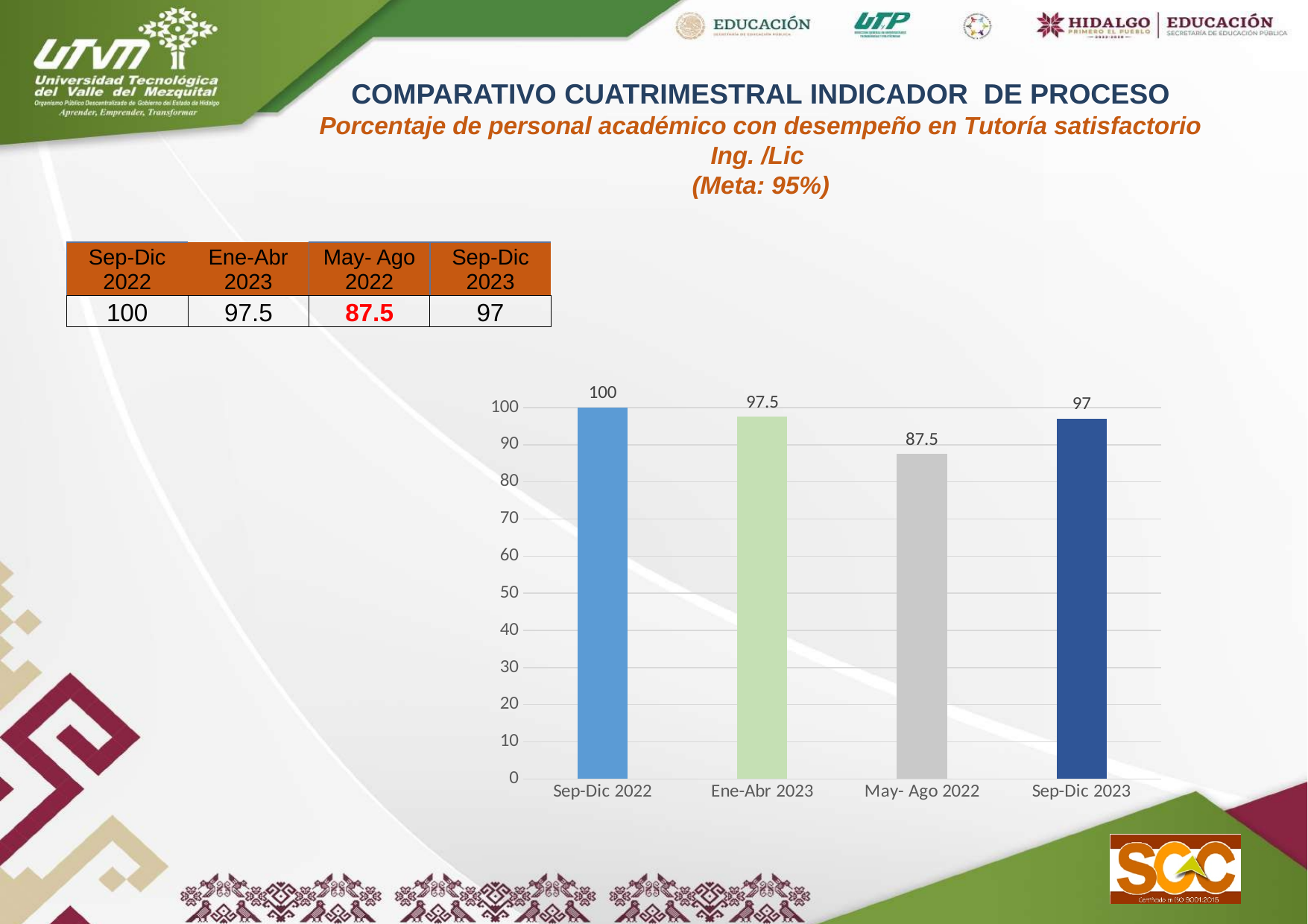
What is the difference between the values for Sep-Dic 2022 and May- Ago 2022? 12.5 Is the value for May- Ago 2022 greater or less than 90? less What kind of chart is shown on the slide? bar chart What is the value for May- Ago 2022? 87.5 What is the value for Sep-Dic 2023? 97 What is the value for Sep-Dic 2022? 100 Which is larger, the value for Ene-Abr 2023 or the value for May- Ago 2022? Ene-Abr 2023 Which category has the highest value? Sep-Dic 2022 How many categories are shown on the x axis of the chart? 4 Which category has the lowest value? May- Ago 2022 What is the difference between the values for Ene-Abr 2023 and Sep-Dic 2023? 0.5 What is the value for Ene-Abr 2023? 97.5